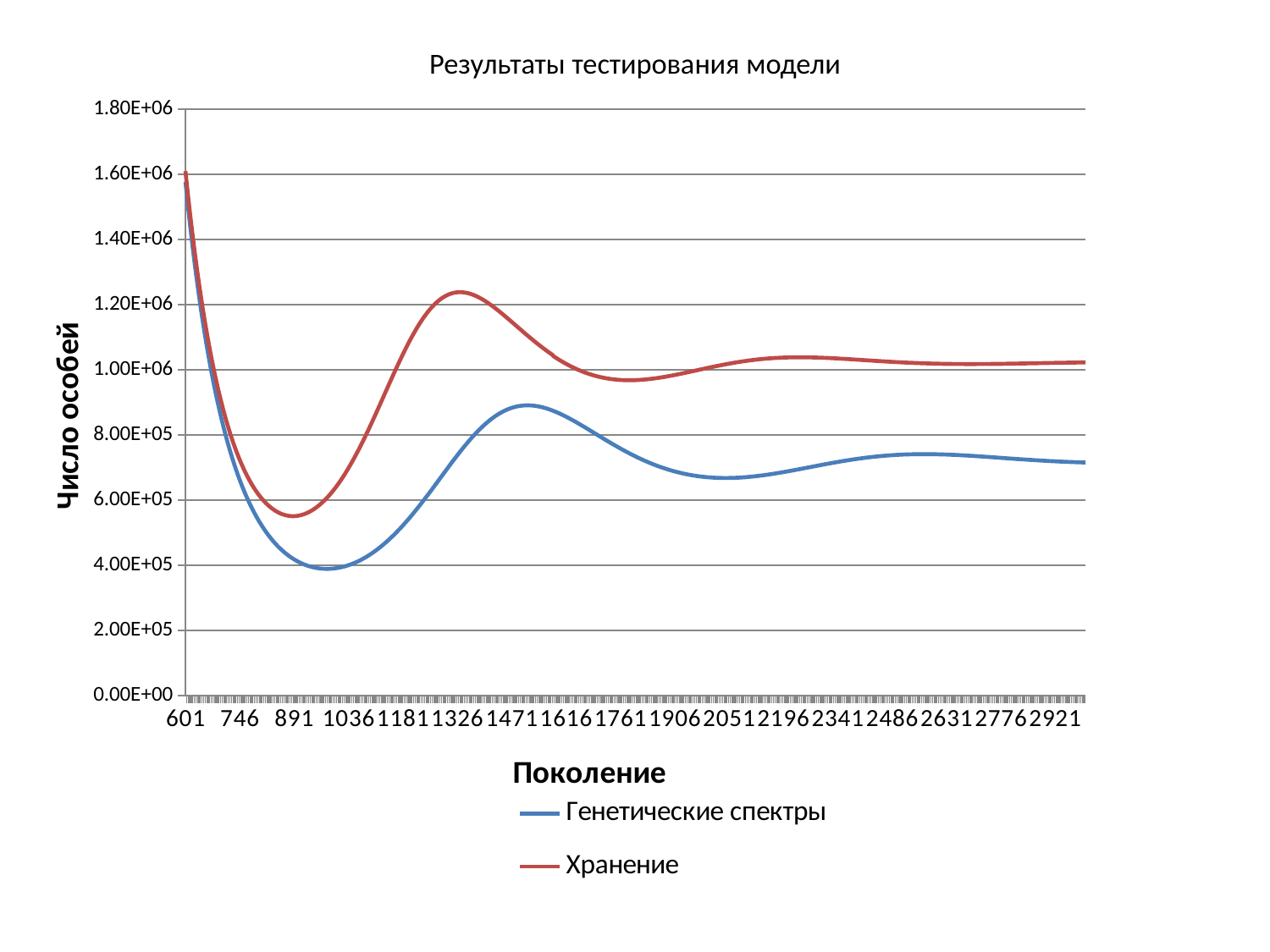
Is the value for Генетические спектры at generation 2921 greater or less than 8.00E+05? less Which series has the lower value at generation 2921? Генетические спектры What kind of chart is shown on the slide? line chart Is the lowest value of Генетические спектры greater or less than 6.00E+05? less What is the title of the chart? Результаты тестирования модели Is the peak value of Хранение near generation 1326 greater or less than 1.20E+06? greater How many generation labels are shown on the x axis? 17 Which series is drawn in red? Хранение Do the values of both series rise or fall between generation 601 and generation 891? fall How many series does the legend list? 2 Which series has the higher value at generation 1326? Хранение